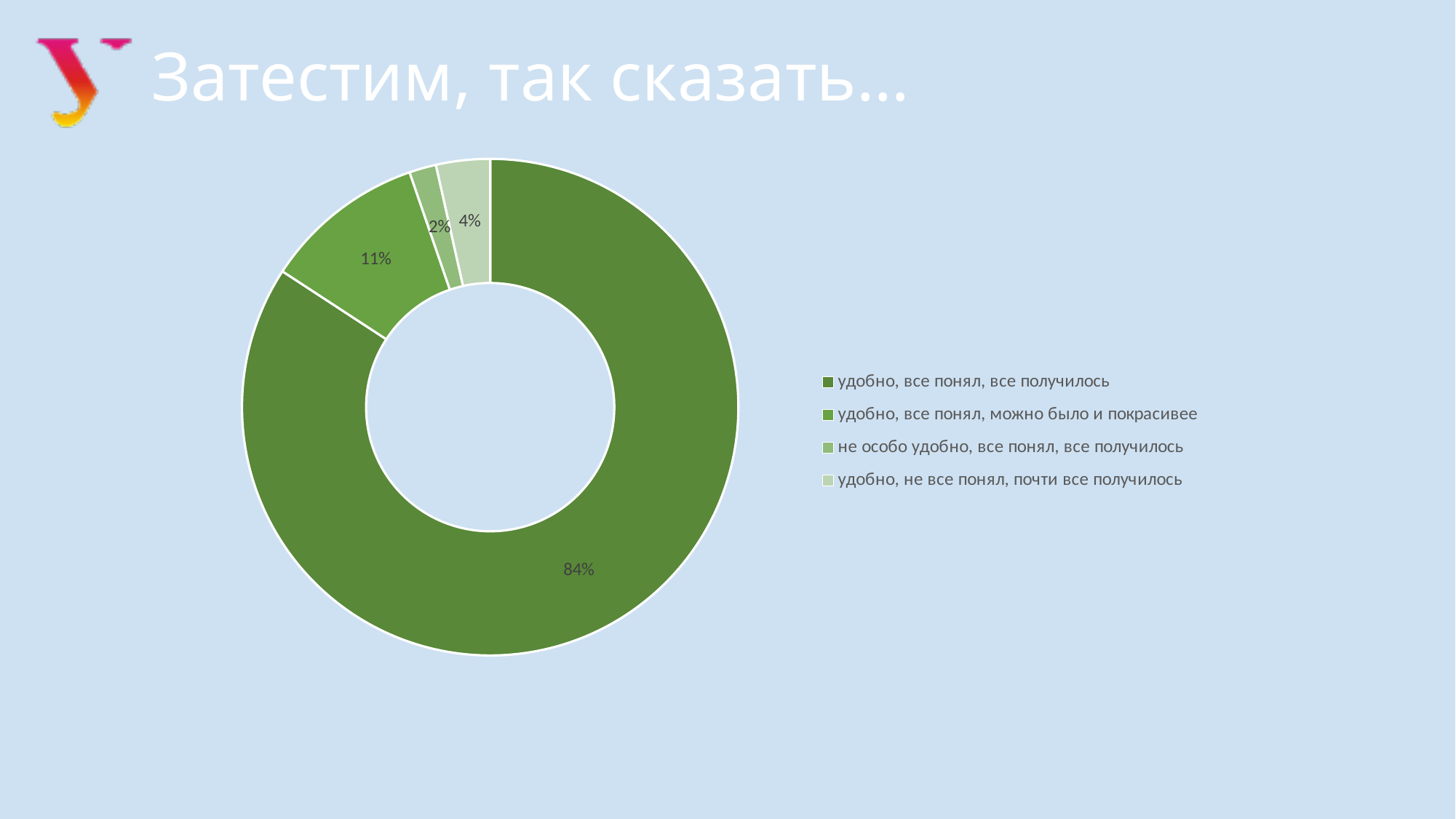
What percentage is shown for "не особо удобно, все понял, все получилось"? 2% Which category has the largest share of the doughnut? удобно, все понял, все получилось What percentage is shown for "удобно, не все понял, почти все получилось"? 4% How many entries does the legend list? 4 Which category has the smallest share of the doughnut? не особо удобно, все понял, все получилось What percentage is shown for "удобно, все понял, все получилось"? 84% What kind of chart is shown on the slide? Doughnut chart How many categories does the doughnut chart show? 4 What is the difference in percentage points between "удобно, все понял, все получилось" and "удобно, все понял, можно было и покрасивее"? 73 Which is larger: the share for "удобно, не все понял, почти все получилось" or for "не особо удобно, все понял, все получилось"? удобно, не все понял, почти все получилось What is the title of the slide? Затестим, так сказать… What percentage is shown for "удобно, все понял, можно было и покрасивее"? 11%